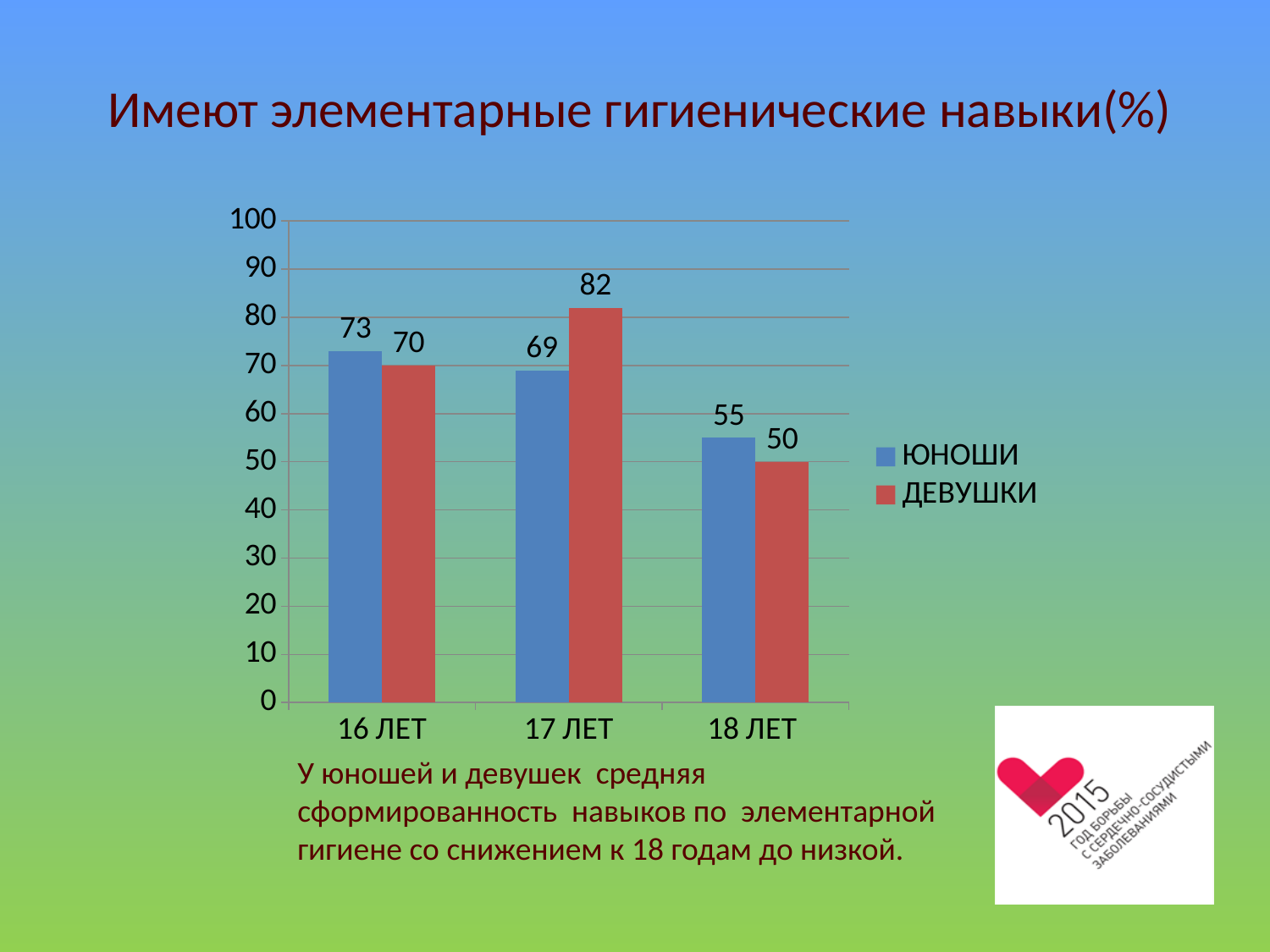
Which is larger at 16 ЛЕТ, ЮНОШИ or ДЕВУШКИ? ЮНОШИ What is the difference between ДЕВУШКИ and ЮНОШИ at 17 ЛЕТ? 13 What is the value for ДЕВУШКИ at 18 ЛЕТ? 50 How many series does the legend list? 2 Which age group has the lowest value for ЮНОШИ? 18 ЛЕТ What is the value for ДЕВУШКИ at 17 ЛЕТ? 82 What kind of chart is shown on the slide? bar chart How many age categories are shown on the x axis? 3 What is the value for ЮНОШИ at 16 ЛЕТ? 73 What is the title of the chart? Имеют элементарные гигиенические навыки(%) Is the value for ЮНОШИ at 18 ЛЕТ greater or less than 60? less Which age group has the highest value for ДЕВУШКИ? 17 ЛЕТ